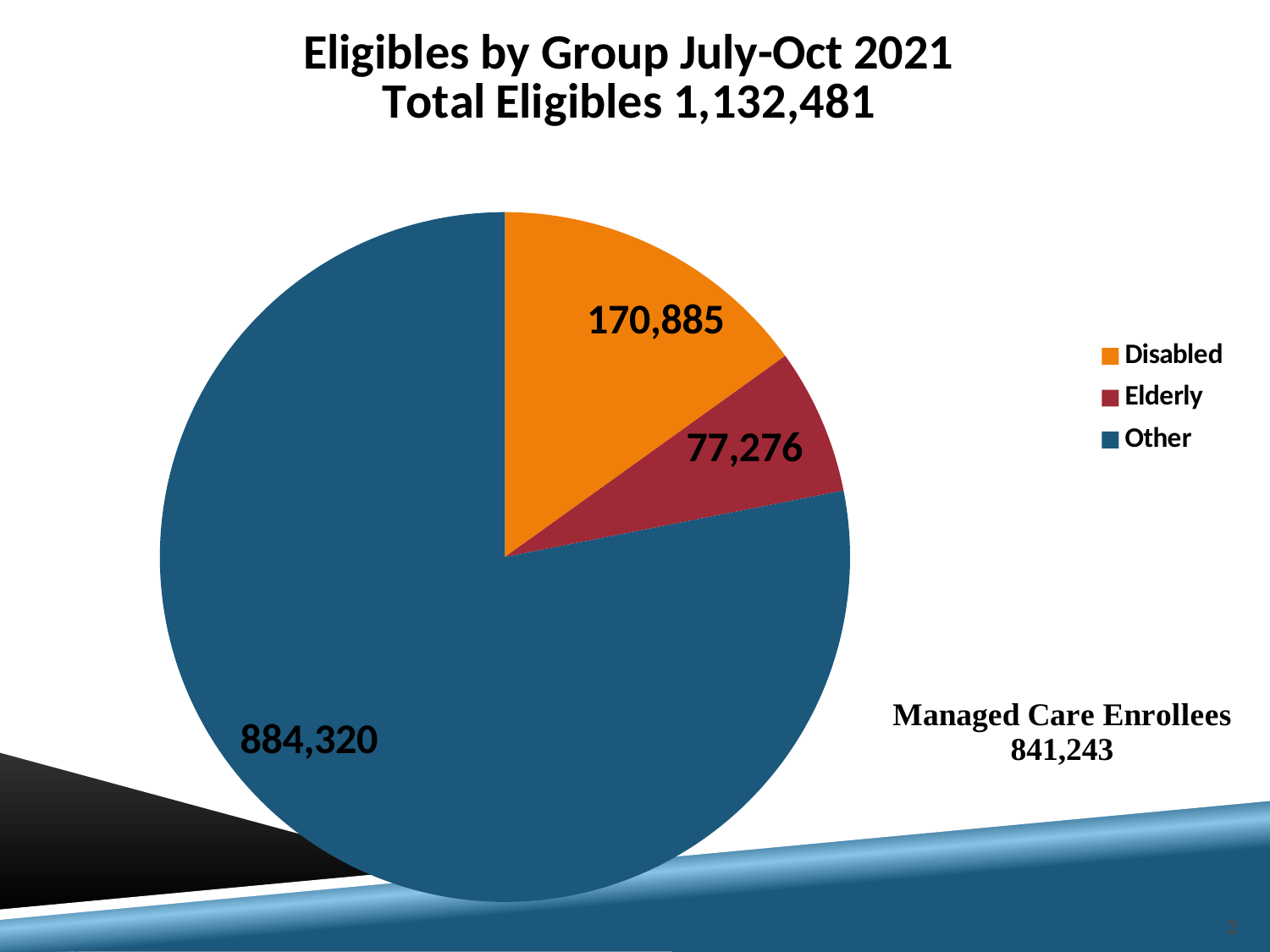
What is the value for the Elderly group? 77,276 How many slices does the pie chart have? 3 What is the title of the chart? Eligibles by Group July-Oct 2021 Total Eligibles 1,132,481 What kind of chart is shown on the slide? Pie chart What is the value for the Other group? 884,320 Which is larger, the Disabled group or the Elderly group? Disabled Which group has the largest slice of the pie? Other What is the difference between the Disabled value and the Elderly value? 93,609 What is the value for the Disabled group? 170,885 How many groups does the legend list? 3 Which group has the smallest slice of the pie? Elderly